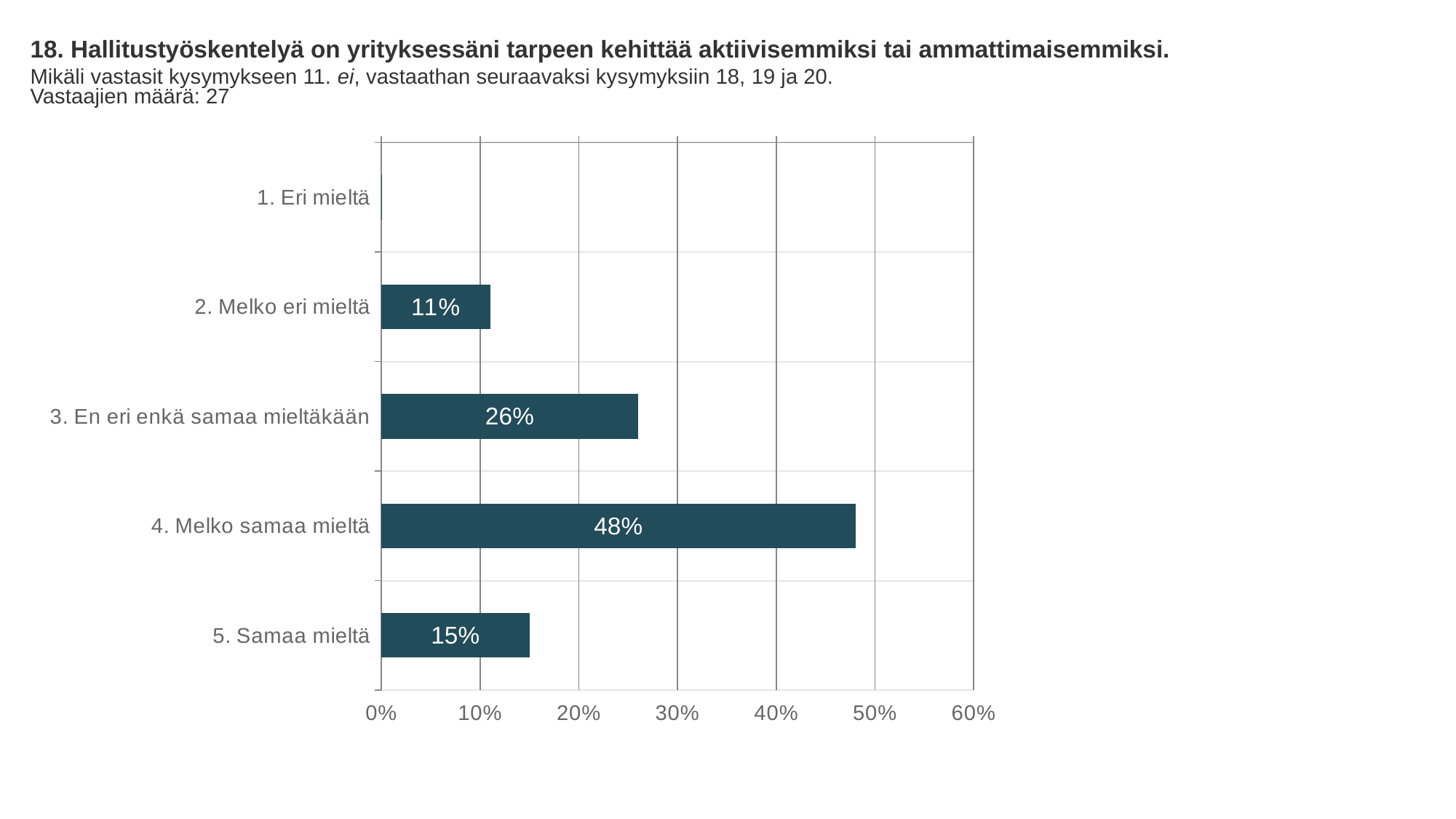
What is the value for '3. En eri enkä samaa mieltäkään'? 26% What is the value for '2. Melko eri mieltä'? 11% What is the number of respondents (Vastaajien määrä) stated on the slide? 27 What is the difference between the values for '4. Melko samaa mieltä' and '3. En eri enkä samaa mieltäkään'? 22% What is the value for '4. Melko samaa mieltä'? 48% Which category has the lowest value? 1. Eri mieltä What kind of chart is shown on the slide? bar chart Which is larger, the value for '5. Samaa mieltä' or '2. Melko eri mieltä'? 5. Samaa mieltä Which category has the highest value? 4. Melko samaa mieltä Is the value for '1. Eri mieltä' greater or less than 10%? less What is the value for '5. Samaa mieltä'? 15% How many categories are shown in the chart? 5